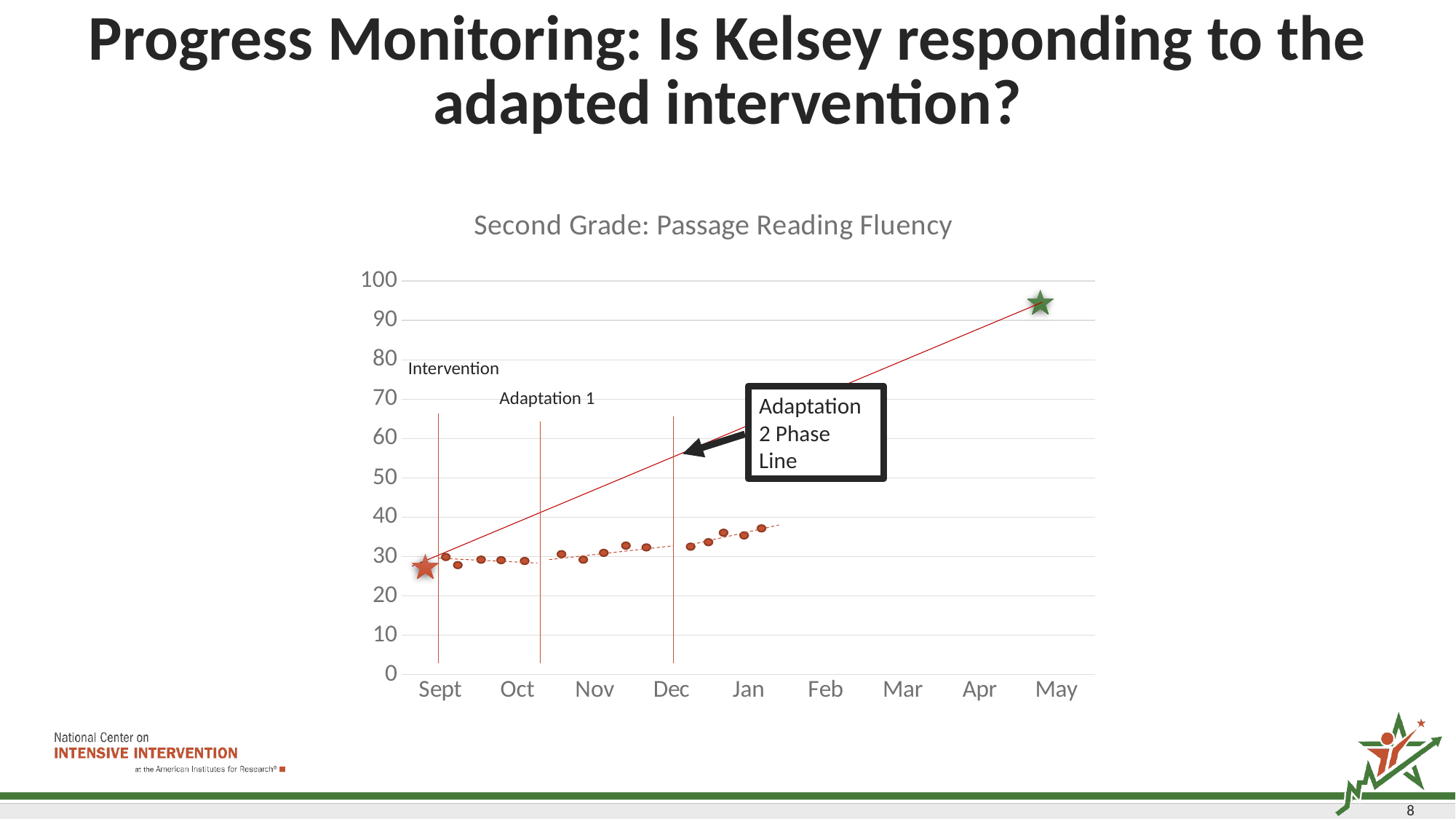
Which is higher, the goal line at May or the progress-monitoring data points in Jan? the goal line at May Is the value of the green star goal marker at May greater or less than 90? greater How many months are labelled along the x axis of the chart? 9 Is the last plotted progress-monitoring data point (around Jan) greater or less than 40? less Is the goal line value at Dec greater or less than 50? greater What is the highest value shown on the y axis? 100 What kind of chart is shown on the slide? line chart Which month is the first label on the x axis? Sept Do the plotted progress-monitoring data points generally rise or fall from Sept to Jan? rise What is the title of the chart? Second Grade: Passage Reading Fluency